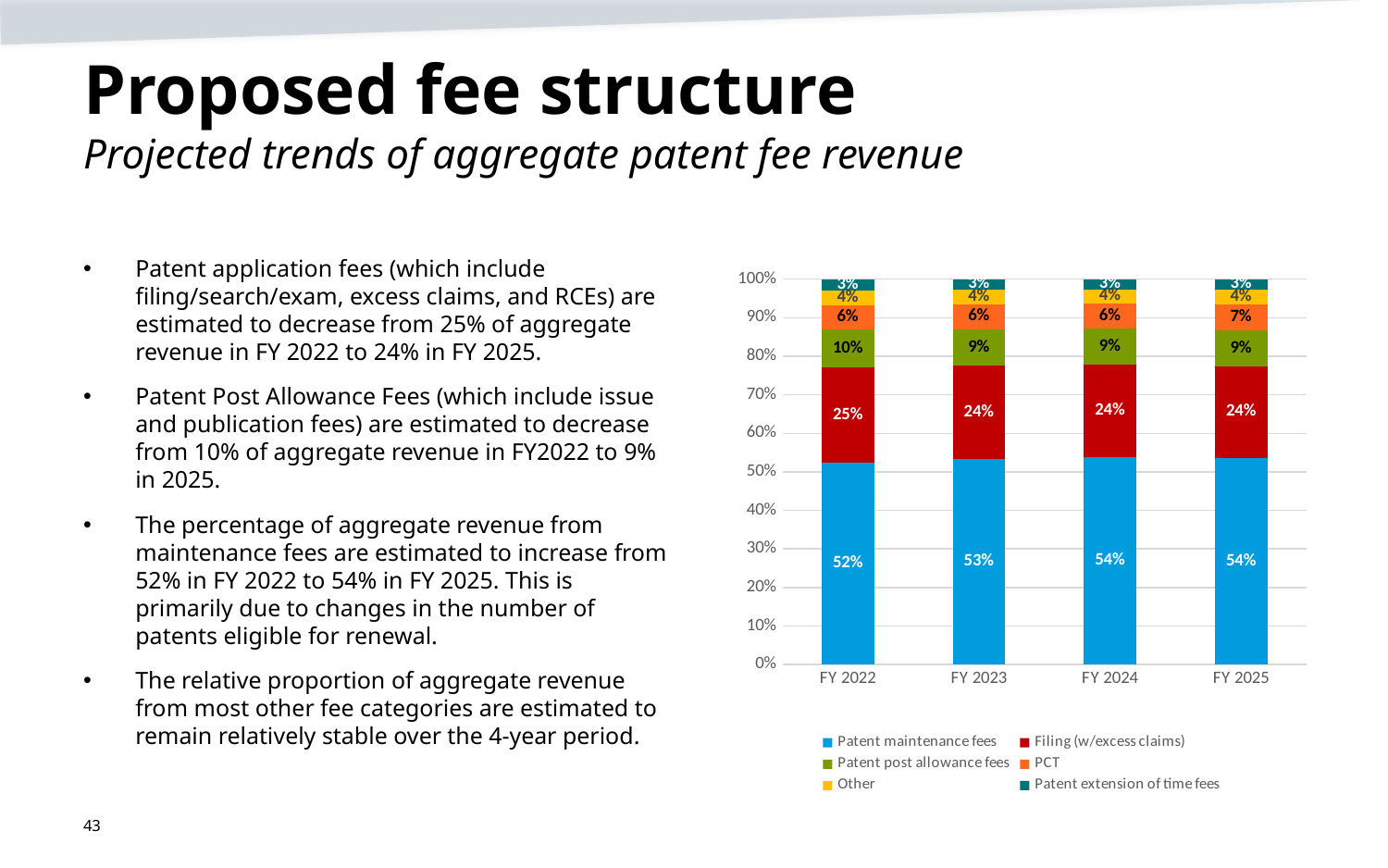
What is the value for PCT in FY 2025? 7% What percentage of aggregate revenue comes from patent maintenance fees in FY 2022? 52% How many series does the legend list? 6 What is the difference between the patent maintenance fees share in FY 2025 and in FY 2022? 2% What is the value for patent post allowance fees in FY 2022? 10% What is the value for Filing (w/excess claims) in FY 2025? 24% What kind of chart is shown on the slide? Stacked bar chart Which is larger: the Filing (w/excess claims) share in FY 2022 or in FY 2023? FY 2022 How many fiscal years are shown on the x axis? 4 In which fiscal year is the patent maintenance fees share lowest? FY 2022 Does the patent maintenance fees share rise or fall from FY 2022 to FY 2025? Rise Which series is shown in blue in the chart? Patent maintenance fees